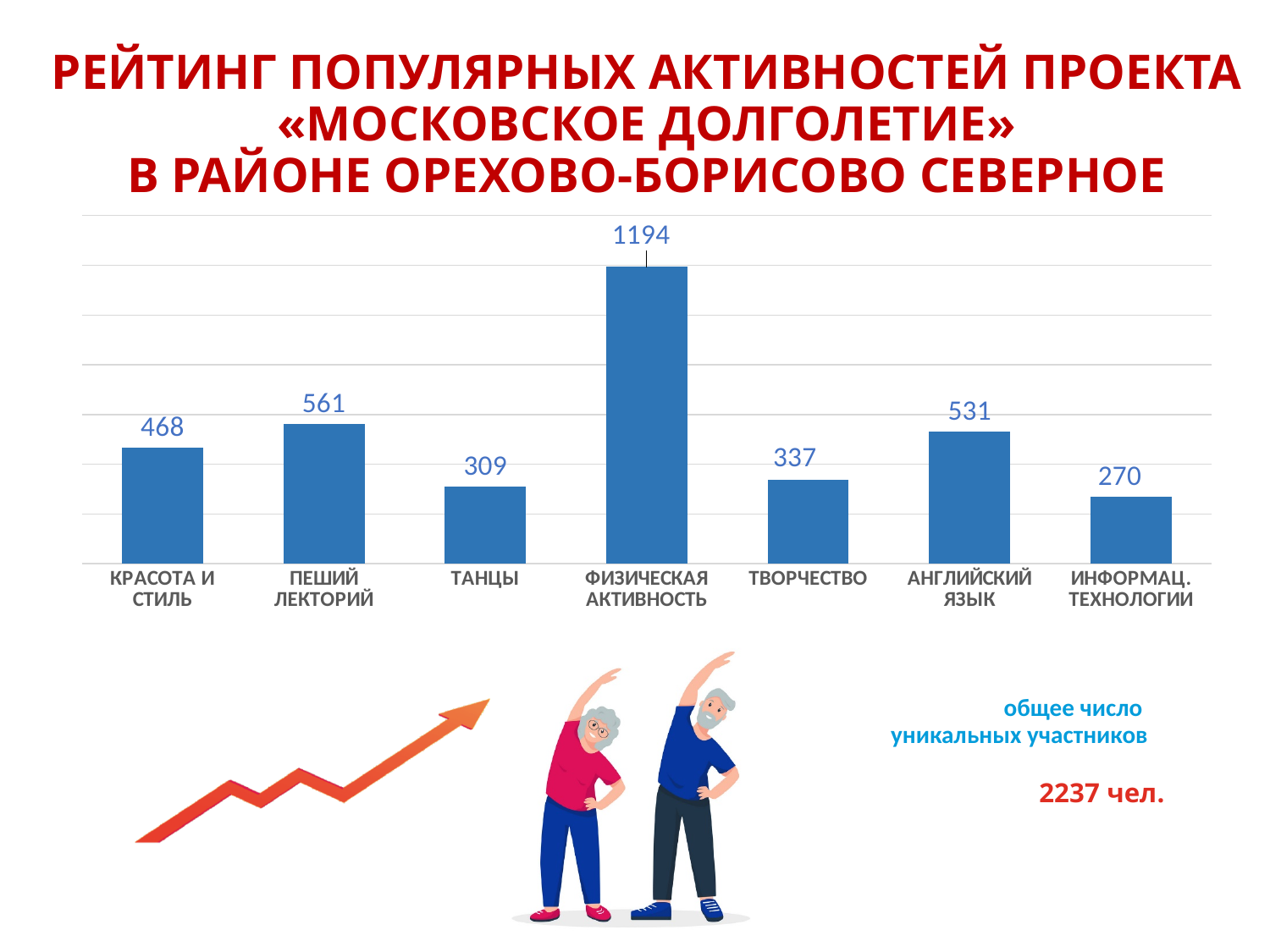
Which is larger, the value for КРАСОТА И СТИЛЬ or the value for ТВОРЧЕСТВО? КРАСОТА И СТИЛЬ What is the difference between the values for ПЕШИЙ ЛЕКТОРИЙ and АНГЛИЙСКИЙ ЯЗЫК? 30 What is the value for ПЕШИЙ ЛЕКТОРИЙ? 561 What is the value for ТВОРЧЕСТВО? 337 What kind of chart is shown on the slide? Bar chart What is the total number of unique participants stated on the slide? 2237 чел. How many categories are shown in the chart? 7 What is the difference between the values for КРАСОТА И СТИЛЬ and ТАНЦЫ? 159 Which category has the highest value? ФИЗИЧЕСКАЯ АКТИВНОСТЬ What is the value for ФИЗИЧЕСКАЯ АКТИВНОСТЬ? 1194 What is the value for ИНФОРМАЦ. ТЕХНОЛОГИИ? 270 Which category has the lowest value? ИНФОРМАЦ. ТЕХНОЛОГИИ